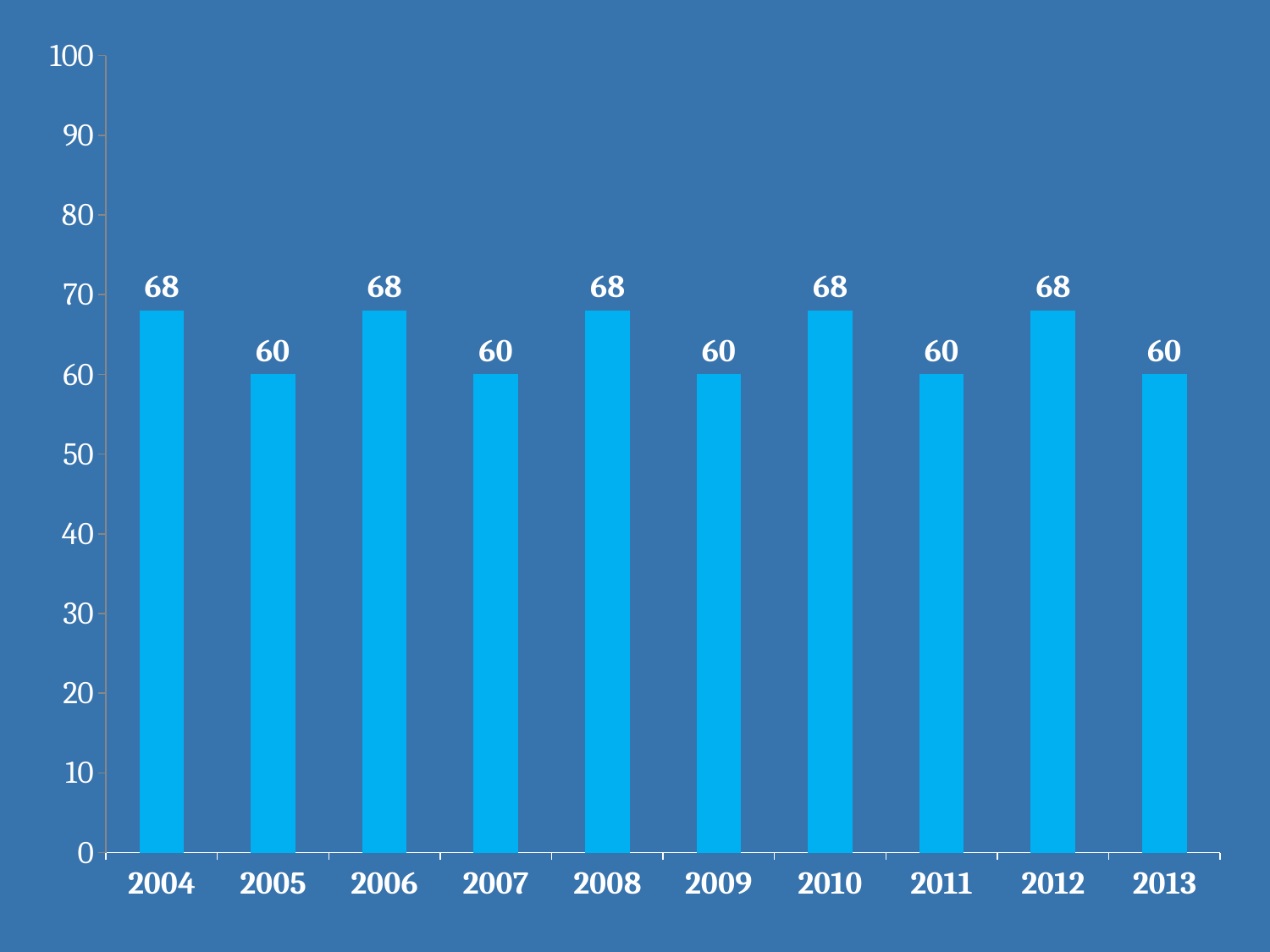
What is the highest value shown on the y axis? 100 Is the value for 2012 greater or less than 50? greater What colour are the bars? light blue What is the value for 2010? 68 Which is larger, the value for 2008 or the value for 2009? 2008 Is the value for 2007 greater or less than 70? less How many years are shown on the x axis? 10 What is the value for 2013? 60 What is the value for 2005? 60 What kind of chart is this? bar chart What is the value for 2004? 68 What is the difference between the values for 2004 and 2005? 8